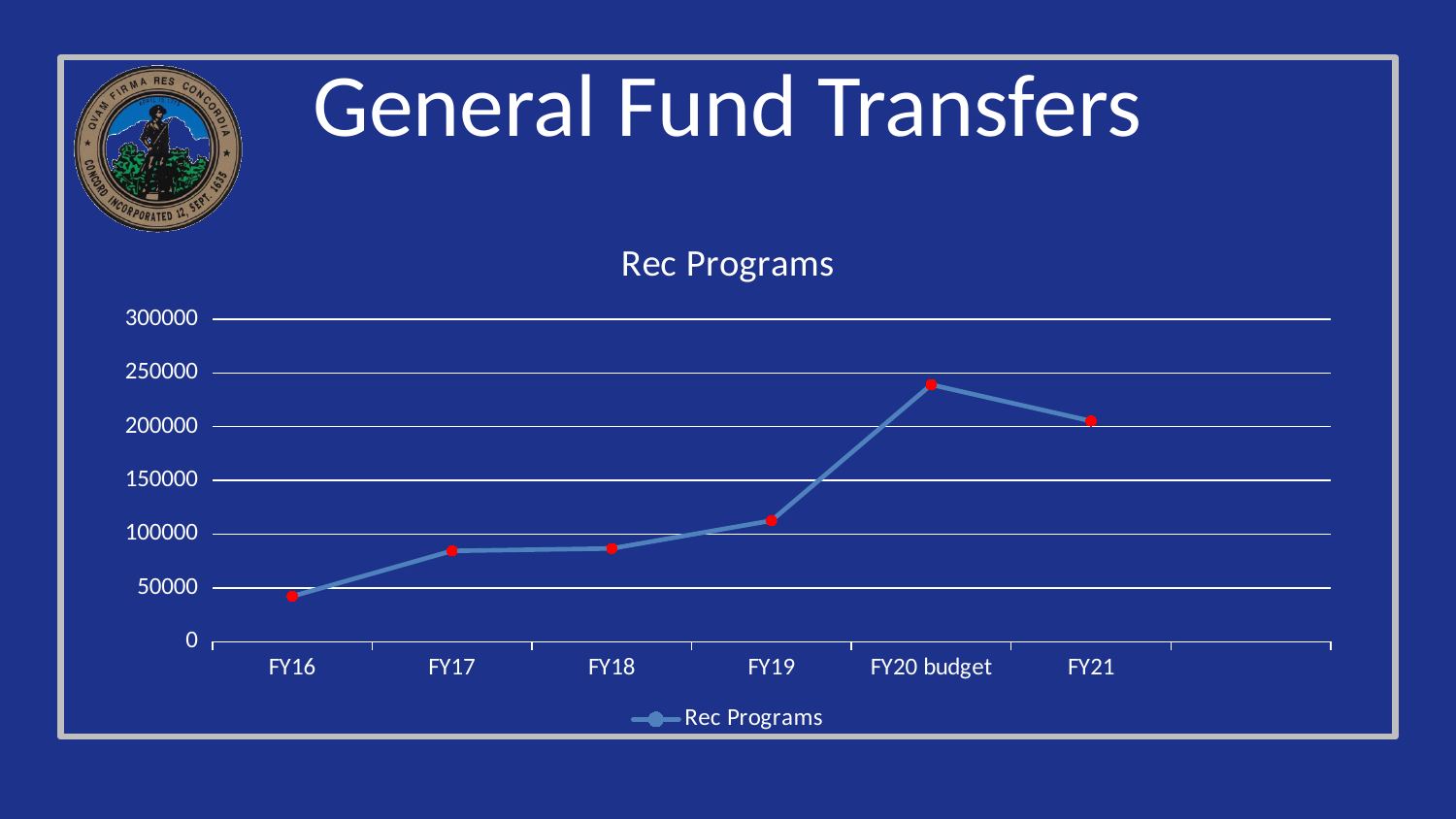
Which is larger, the value for FY20 budget or the value for FY21? FY20 budget What kind of chart is shown on the slide? line chart Does the value rise or fall from FY19 to FY20 budget? rise Is the value for FY16 greater or less than 50000? less Which category has the highest value? FY20 budget Is the value for FY20 budget greater or less than 250000? less What is the title of the chart? Rec Programs Which category has the lowest value? FY16 Is the value for FY19 greater or less than 100000? greater How many points are plotted along the x axis? 6 How many series does the legend list? 1